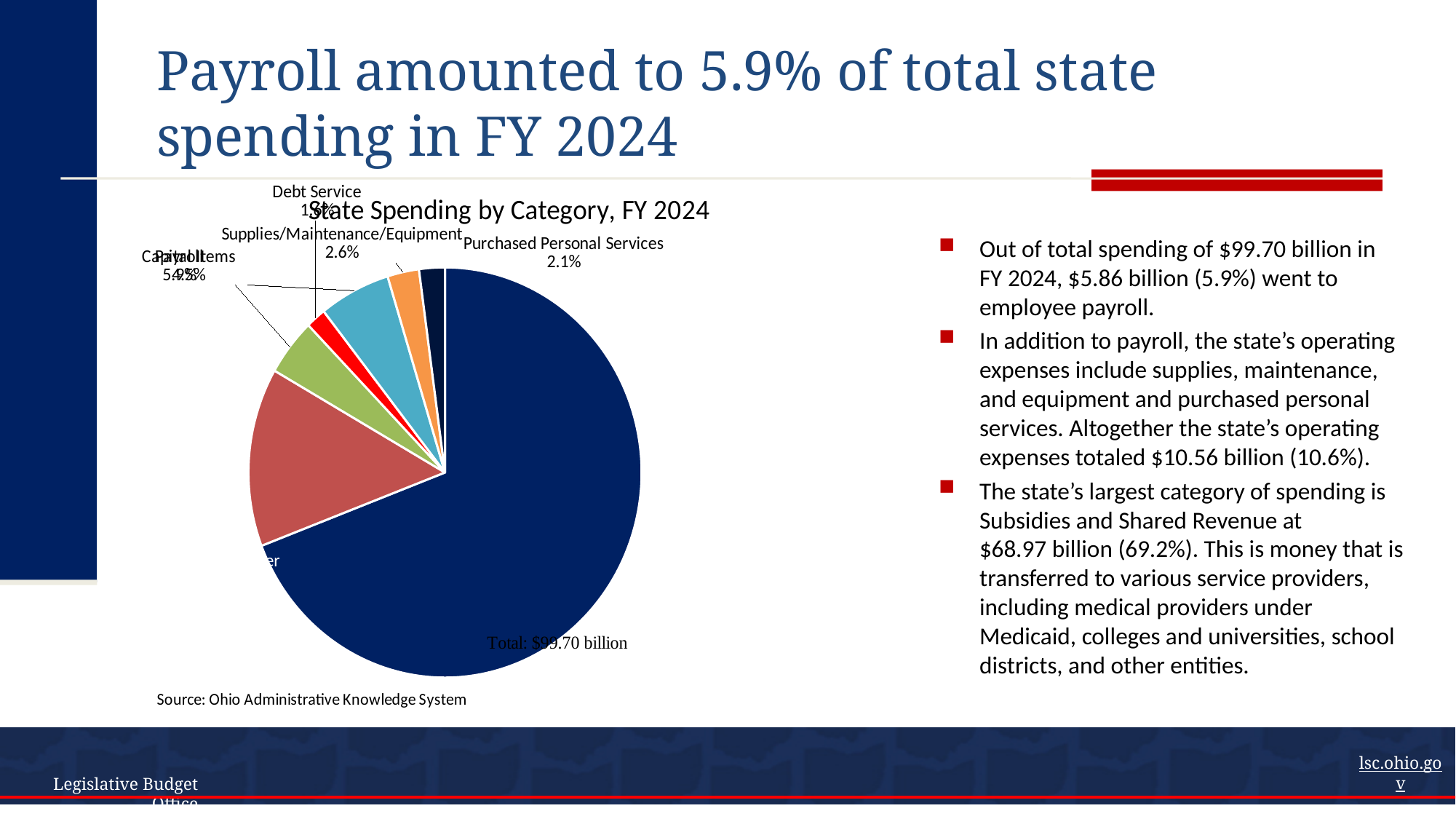
What share of state spending does the chart show for Purchased Personal Services? 2.1% What is the title of the chart? State Spending by Category, FY 2024 What source is cited below the chart? Ohio Administrative Knowledge System How many slices does the pie chart have? 7 What is the difference between the Supplies/Maintenance/Equipment share and the Purchased Personal Services share? 0.5% Which is larger, the share for Supplies/Maintenance/Equipment or the share for Purchased Personal Services? Supplies/Maintenance/Equipment Is the share for Purchased Personal Services greater or less than 5%? less What total spending amount is printed on the chart? $99.70 billion What kind of chart is shown on the slide? pie chart What share of state spending does the chart show for Supplies/Maintenance/Equipment? 2.6%